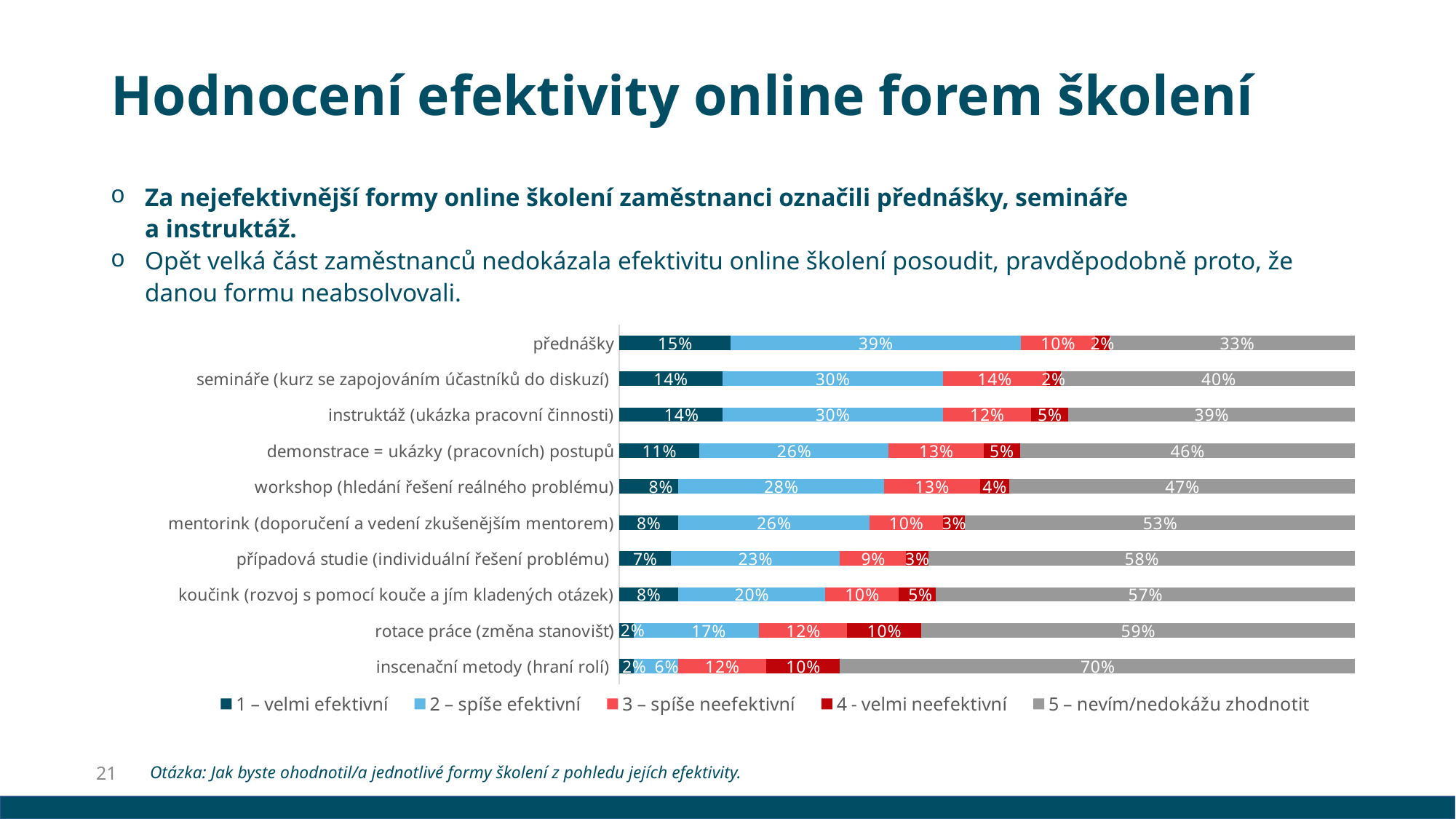
What is the '4 - velmi neefektivní' value for rotace práce (změna stanovišť)? 10% Which colour represents the series '5 – nevím/nedokážu zhodnotit' in the chart? grey How many training forms (categories) are plotted in the chart? 10 Which training form has the highest '1 – velmi efektivní' share? přednášky What percentage of respondents rated přednášky as '2 – spíše efektivní'? 39% What is the combined share of '1 – velmi efektivní' and '2 – spíše efektivní' for semináře (kurz se zapojováním účastníků do diskuzí)? 44% What is the '5 – nevím/nedokážu zhodnotit' value for inscenační metody (hraní rolí)? 70% What kind of chart is shown on the slide? stacked bar chart Which training form has the lowest '5 – nevím/nedokážu zhodnotit' share? přednášky What is the difference between the '5 – nevím/nedokážu zhodnotit' values for inscenační metody (hraní rolí) and přednášky? 37% How many series does the chart legend list? 5 Which has a larger '2 – spíše efektivní' share: workshop (hledání řešení reálného problému) or koučink (rozvoj s pomocí kouče a jím kladených otázek)? workshop (hledání řešení reálného problému)